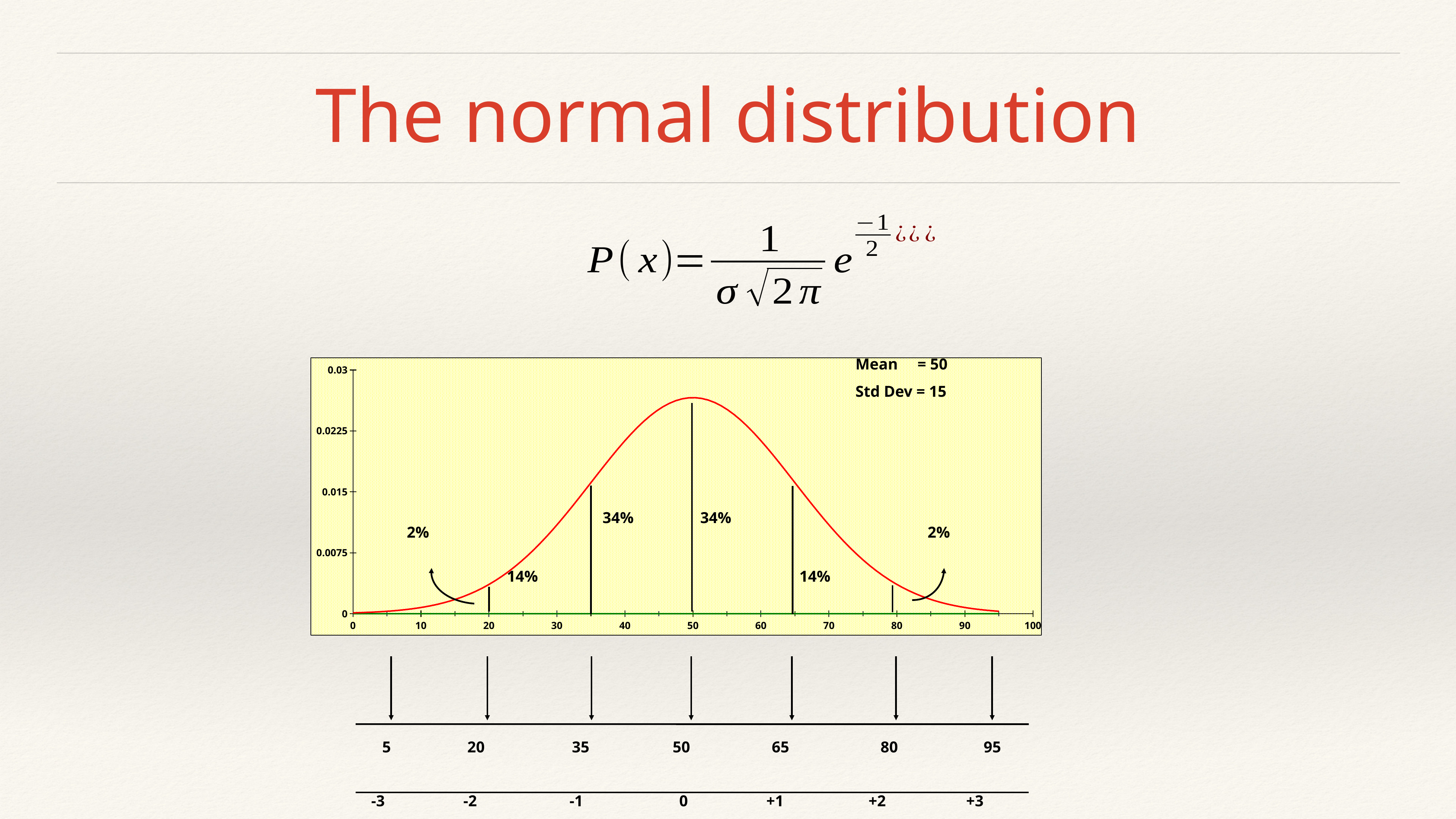
At which x value does the curve reach its peak? 50 What percentage label is shown for the tail beyond 80 on the right side of the chart? 2% What percentage label is shown between the vertical lines at 35 and 50? 34% What is the highest value shown on the x axis of the chart? 100 What is the highest value shown on the y axis of the chart? 0.03 Is the peak value of the curve greater or less than 0.0225? greater What is the combined percentage of the two 34% regions on either side of the mean? 68% What is the standard deviation of the distribution shown in the chart? 15 Is the value of the curve at x = 20 greater or less than 0.0075? less What kind of chart is shown on the slide? line chart What percentage label is shown between the vertical lines at 65 and 80? 14% What is the mean of the distribution shown in the chart? 50